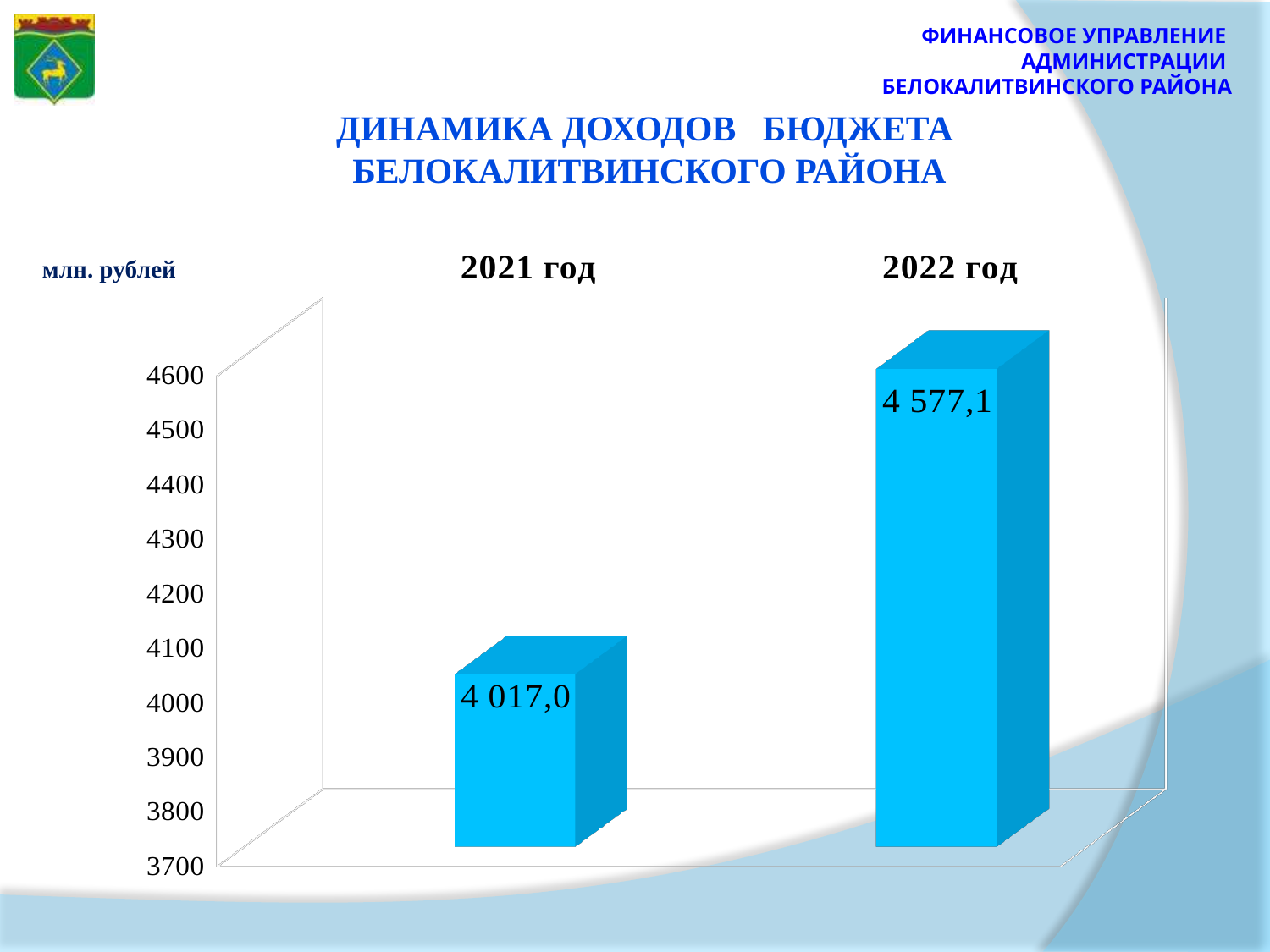
In what units are the values on the chart expressed? млн. рублей What is the difference between the values for 2022 год and 2021 год? 560,1 What is the value for 2021 год? 4 017,0 Is the value for 2021 год greater or less than 4100? less Which is larger, the value for 2021 год or the value for 2022 год? 2022 год Do the values rise or fall from 2021 год to 2022 год? rise Which year has the lowest value? 2021 год Which year has the highest value? 2022 год What kind of chart is shown on the slide? bar chart What is the value for 2022 год? 4 577,1 Is the value for 2022 год greater or less than 4500? greater How many bars are shown in the chart? 2